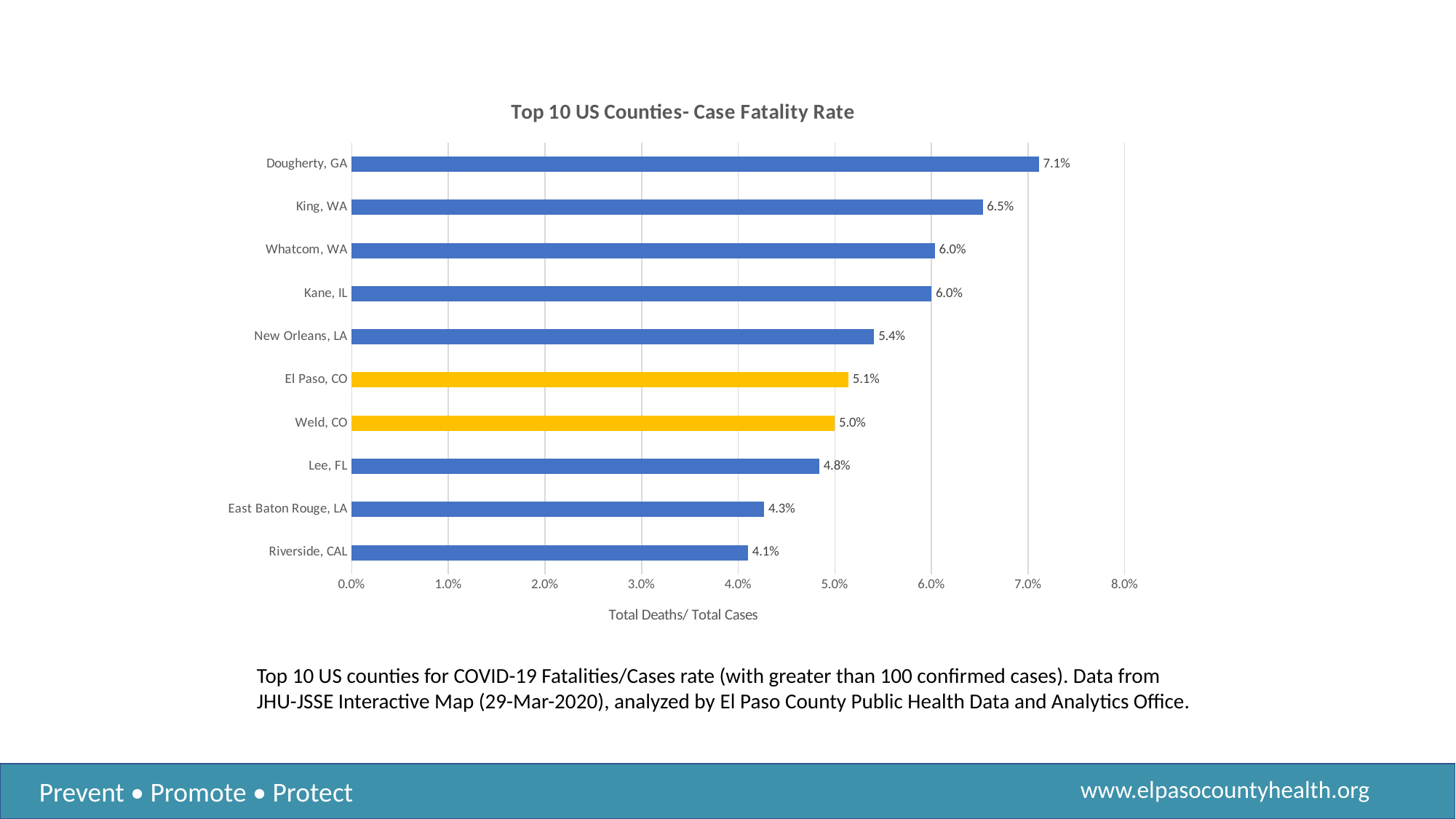
What kind of chart is shown on the slide? Bar chart Which county has the highest case fatality rate? Dougherty, GA What is the case fatality rate for Dougherty, GA? 7.1% Which county has the lowest case fatality rate? Riverside, CAL Which two counties are highlighted with yellow bars? El Paso, CO and Weld, CO What is the case fatality rate for El Paso, CO? 5.1% How many counties are shown in the chart? 10 What is the case fatality rate for East Baton Rouge, LA? 4.3% What is the title of the chart? Top 10 US Counties- Case Fatality Rate Is the value for Riverside, CAL greater or less than 5.0%? less What is the difference between the case fatality rates of King, WA and Lee, FL? 1.7% Which has a higher case fatality rate, New Orleans, LA or Weld, CO? New Orleans, LA